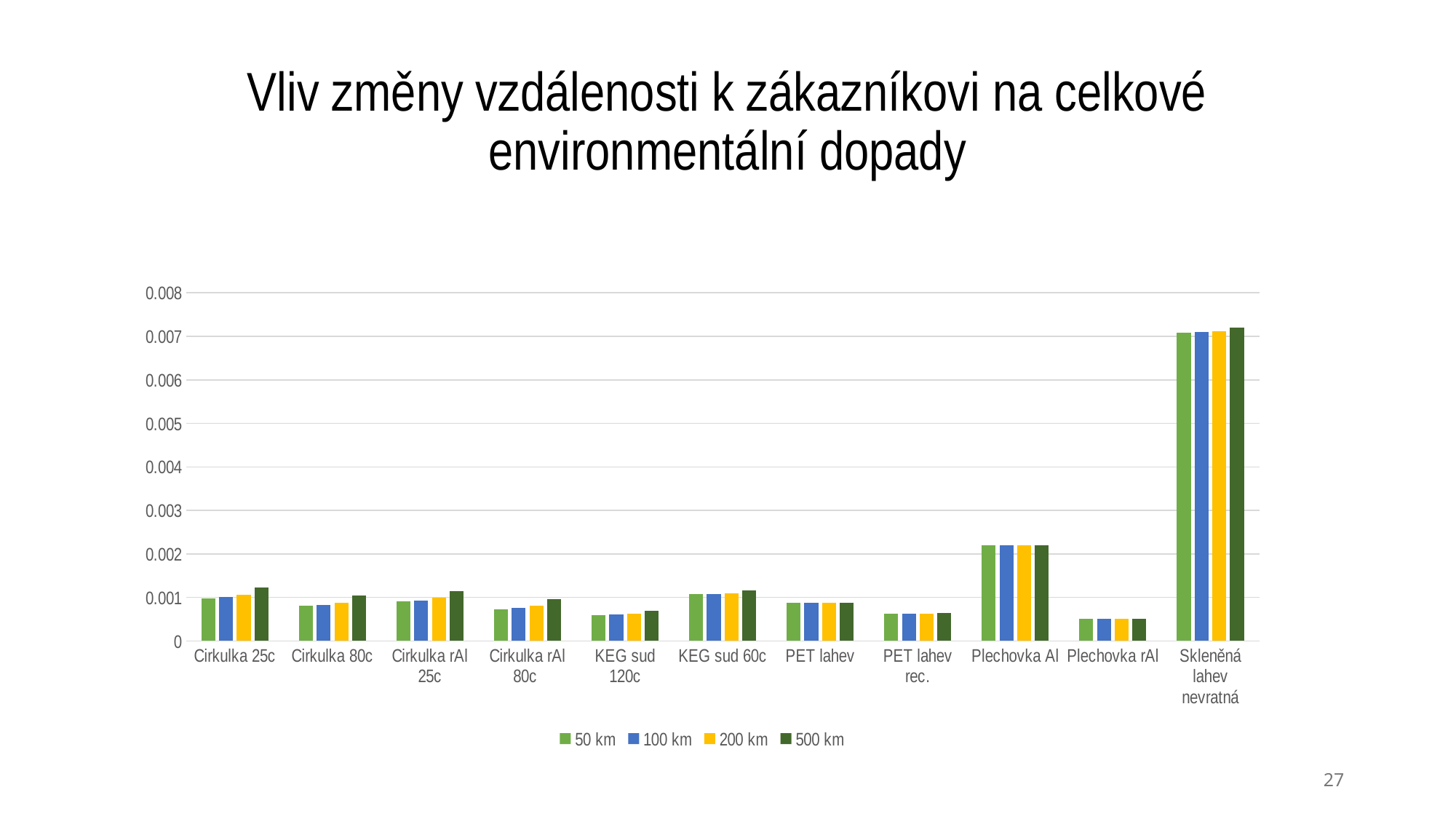
Is the 50 km value for Plechovka Al greater or less than 0.003? less Which has the larger 200 km value, KEG sud 60c or KEG sud 120c? KEG sud 60c Is the 500 km value for Cirkulka 25c greater or less than 0.001? greater Which has the larger 100 km value, Plechovka Al or PET lahev? Plechovka Al How many series does the legend list? 4 What kind of chart is shown on the slide? bar chart What is the title of the chart? Vliv změny vzdálenosti k zákazníkovi na celkové environmentální dopady Is the 50 km value for KEG sud 120c greater or less than 0.001? less Which category has the highest values? Skleněná lahev nevratná How many packaging categories are shown on the x axis? 11 Which category has the lowest values? Plechovka rAl